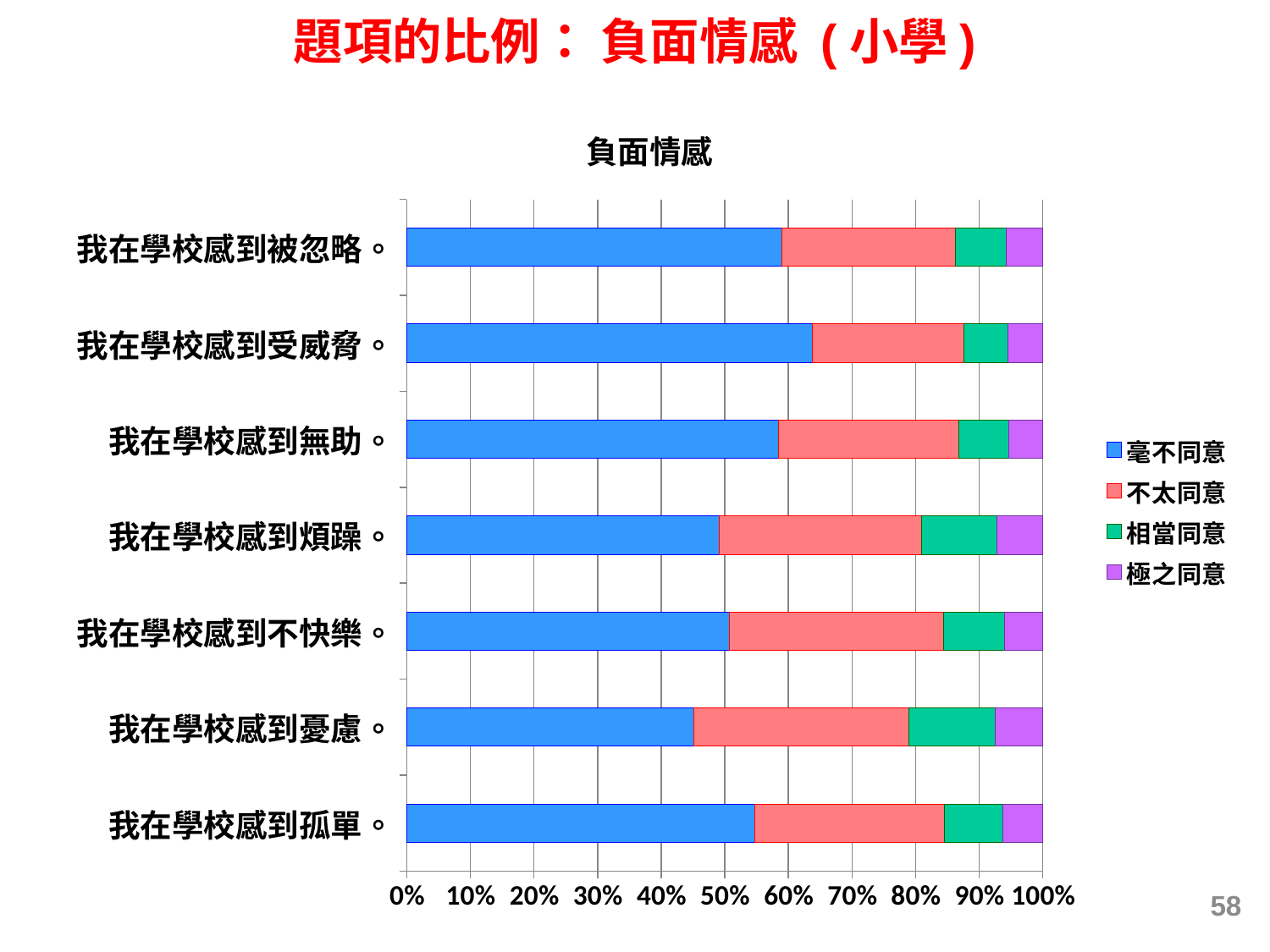
Which statement has the smallest 毫不同意 share? 我在學校感到憂慮 What is the title of the chart? 負面情感 Is the 毫不同意 share for 我在學校感到被忽略 greater or less than 50%? greater Which has a larger 毫不同意 share: 我在學校感到受威脅 or 我在學校感到憂慮? 我在學校感到受威脅 Is the 毫不同意 share for 我在學校感到受威脅 greater or less than 60%? greater Which statement has the largest 毫不同意 share? 我在學校感到受威脅 How many series does the legend list? 4 Is the 毫不同意 share for 我在學校感到憂慮 greater or less than 50%? less What kind of chart is shown on the slide? Stacked bar chart How many statements (categories) are plotted in the chart? 7 Which legend entry is shown in purple? 極之同意